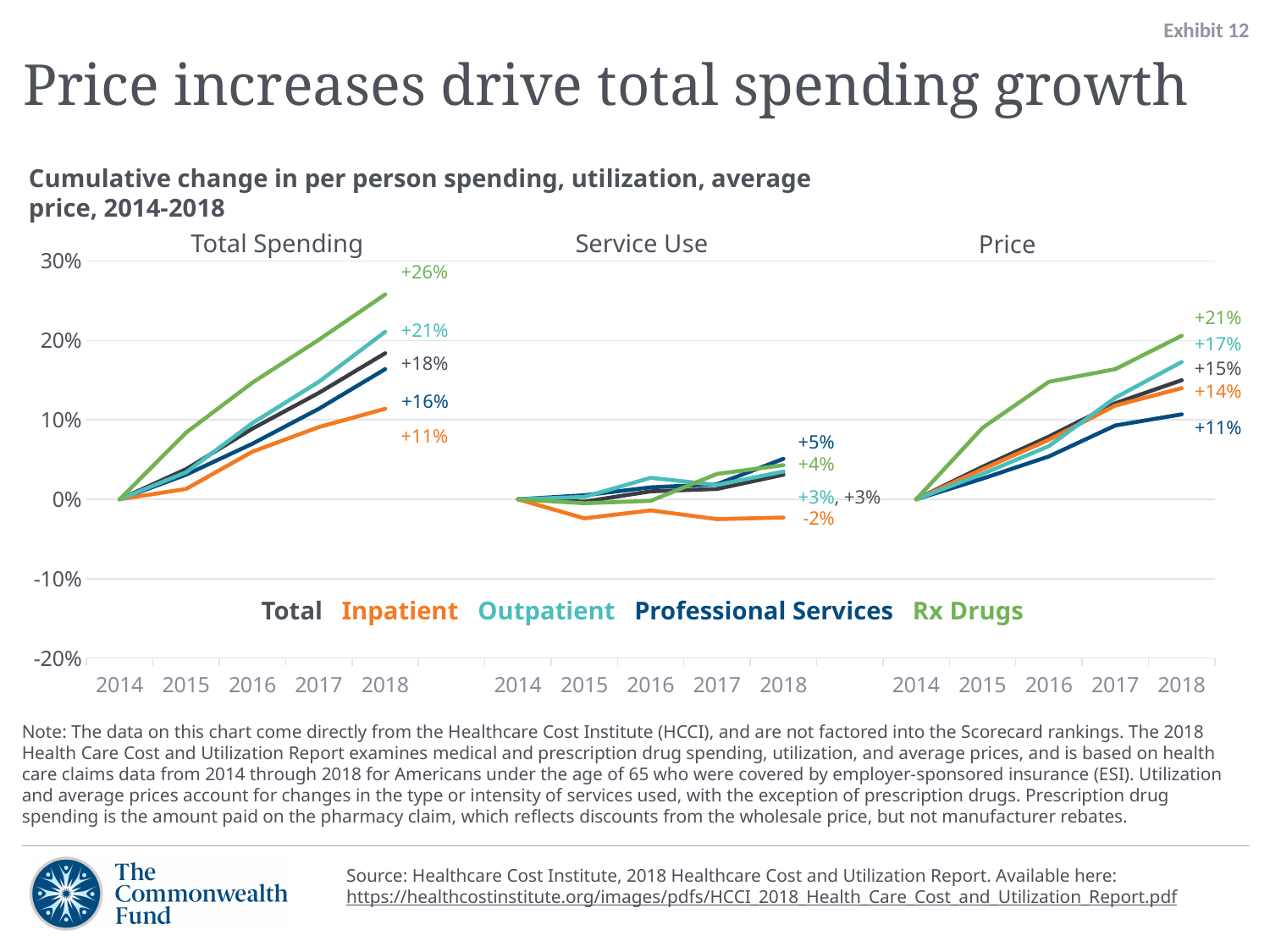
In the Service Use panel, what is the cumulative change for Inpatient in 2018? -2% In the Total Spending panel, what is the cumulative change for Rx Drugs in 2018? +26% How many series does the legend list? 5 In the Price panel, which is larger in 2018: the value for Total or the value for Professional Services? Total In the Price panel, which series has the lowest cumulative change in 2018? Professional Services In the Total Spending panel, what is the cumulative change for Inpatient in 2018? +11% In the Price panel, does the Rx Drugs line rise or fall from 2014 to 2018? Rise In the Price panel, what is the cumulative change for Outpatient in 2018? +17% In the Total Spending panel, which series has the highest cumulative change in 2018? Rx Drugs In the Total Spending panel, what is the difference between the 2018 values for Rx Drugs and Inpatient? 15 percentage points In the Service Use panel, is the 2018 value for Professional Services greater or less than 10%? less What kind of chart is shown on the slide? Line chart